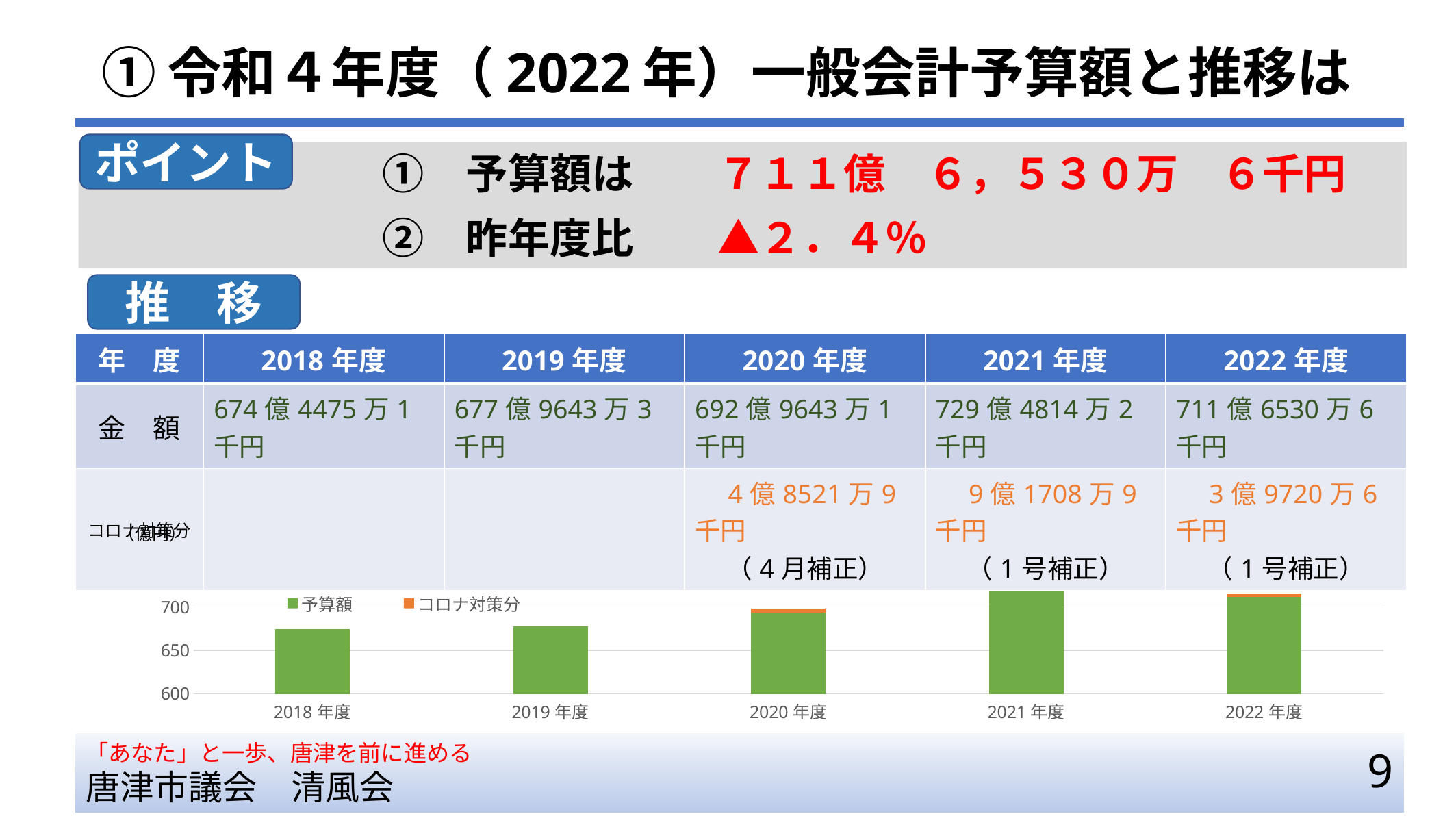
What kind of chart is shown at the bottom of the slide? bar chart Is the 予算額 bar for 2021年度 greater or less than 700? greater Do the bars rise or fall from 2018年度 to 2021年度? rise Is the 予算額 bar for 2022年度 greater or less than 700? greater What colour are the 予算額 bars in the chart? green What are the two series named in the chart legend? 予算額 and コロナ対策分 Which bar is taller in the chart, 2019年度 or 2020年度? 2020年度 Is the 予算額 bar for 2018年度 greater or less than 650? greater How many series does the chart legend list? 2 How many fiscal years (年度) are plotted on the x axis of the chart? 5 Which fiscal year has the tallest bar in the chart? 2021年度